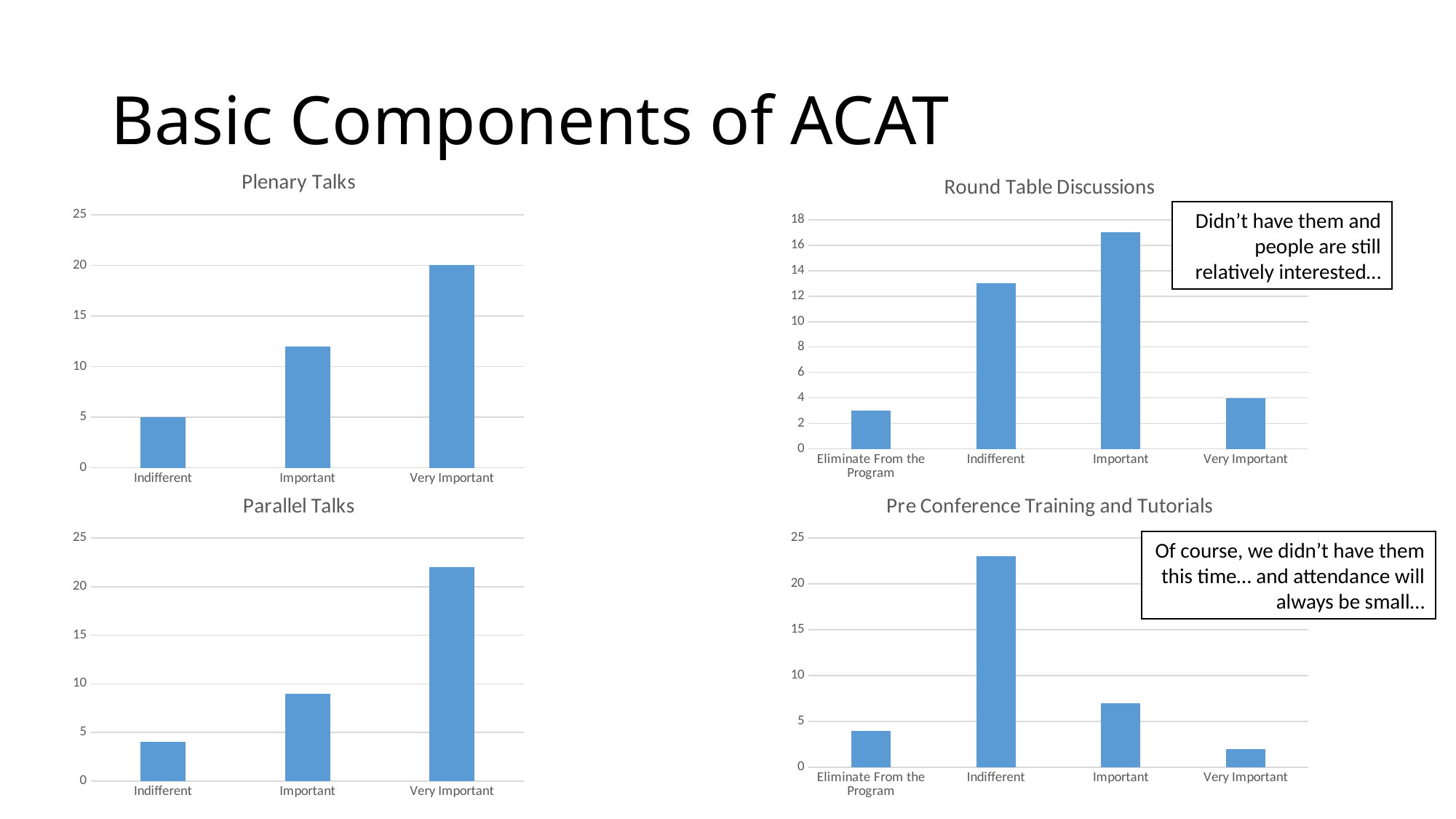
In the Pre Conference Training and Tutorials chart, is the value for Important greater or less than 10? less In the Plenary Talks chart, what is the difference between the Very Important and Indifferent values? 15 How many categories are shown in the Round Table Discussions chart? 4 In the Round Table Discussions chart, what is the value for Very Important? 4 In the Round Table Discussions chart, is the value for Indifferent greater or less than 10? greater In the Plenary Talks chart, what is the value for Indifferent? 5 In the Pre Conference Training and Tutorials chart, which category has the highest value? Indifferent In the Round Table Discussions chart, which category has the highest value? Important In the Parallel Talks chart, is the value for Very Important greater or less than 20? greater What kind of chart is the Parallel Talks chart? Bar chart In the Parallel Talks chart, which category has the lowest value? Indifferent In the Plenary Talks chart, what is the value for Very Important? 20